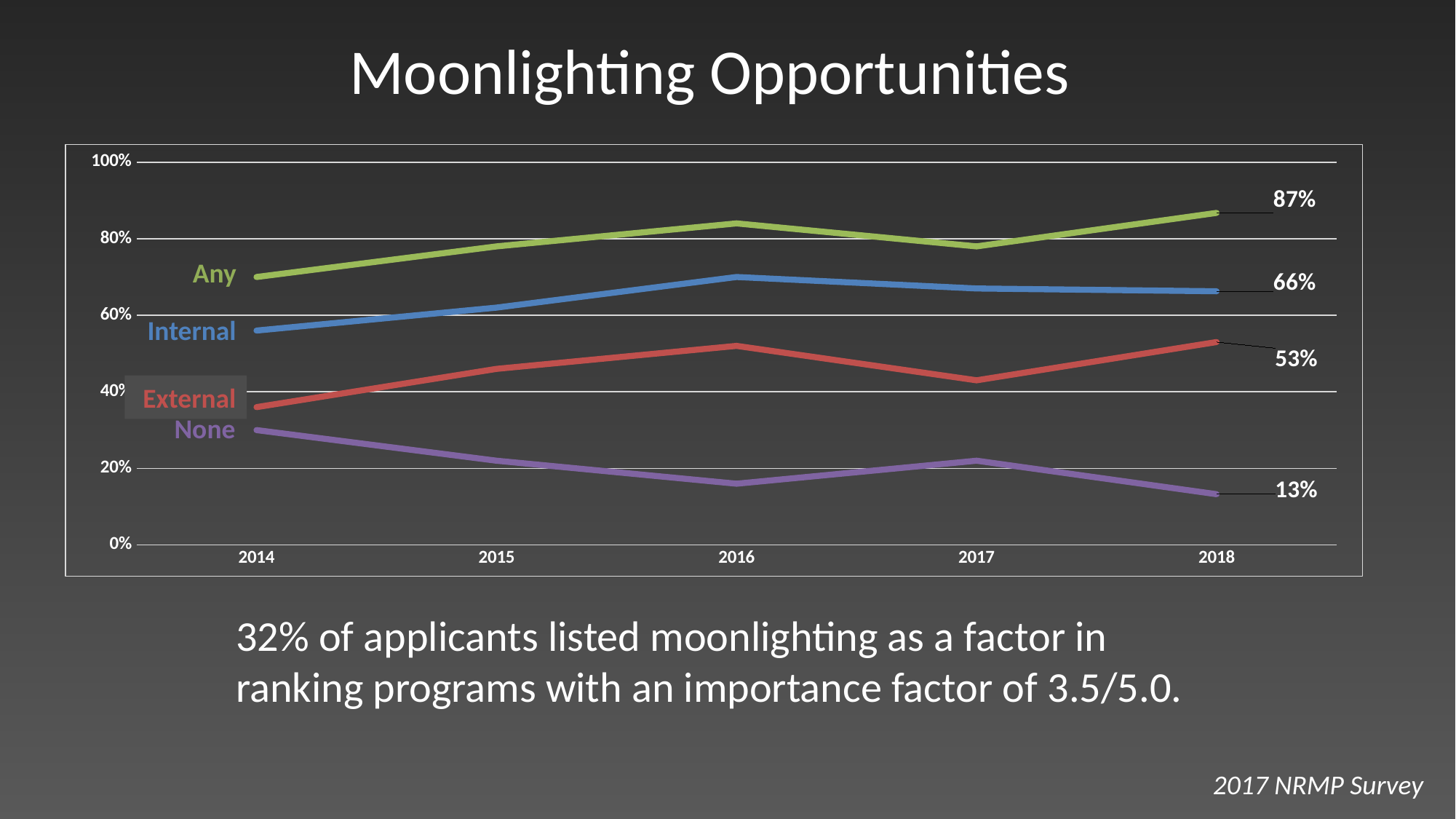
What is the value for Internal in 2018? 66% What is the value for External in 2018? 53% Which series has the highest value in 2018? Any How many series are plotted on the chart? 4 Is the value for None in 2016 greater or less than 20%? less What is the value for None in 2018? 13% How many years are shown on the x axis? 5 What kind of chart is shown on the slide? Line chart Is the value for Any in 2014 greater or less than 60%? greater What is the difference between the Any and Internal values in 2018? 21 percentage points Which series has the lowest value in 2018? None What is the value for Any in 2018? 87%